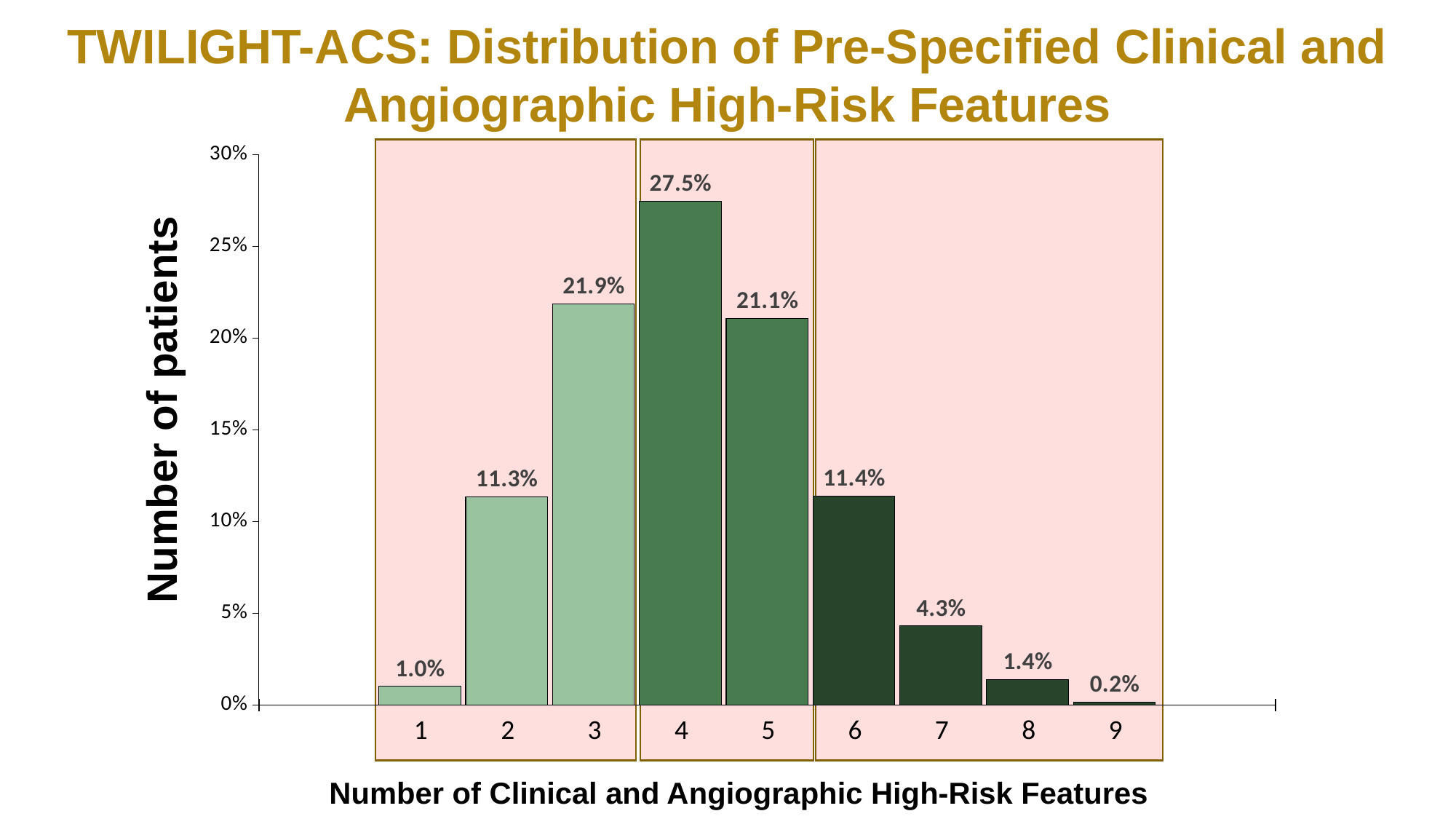
How many categories (numbers of high-risk features) are shown on the x axis? 9 Which has a larger percentage of patients: 3 high-risk features or 6 high-risk features? 3 high-risk features What is the difference between the percentage of patients with 3 features and those with 2 features? 10.6% Is the value for 5 high-risk features greater or less than 20%? greater Which number of high-risk features has the lowest percentage of patients? 9 What percentage of patients had 1 high-risk feature? 1.0% What is the label of the x axis? Number of Clinical and Angiographic High-Risk Features What percentage of patients had 7 high-risk features? 4.3% What kind of chart is shown on the slide? Bar chart What is the difference between the percentage of patients with 4 features and those with 5 features? 6.4% Which number of high-risk features has the highest percentage of patients? 4 What percentage of patients had 4 high-risk features? 27.5%